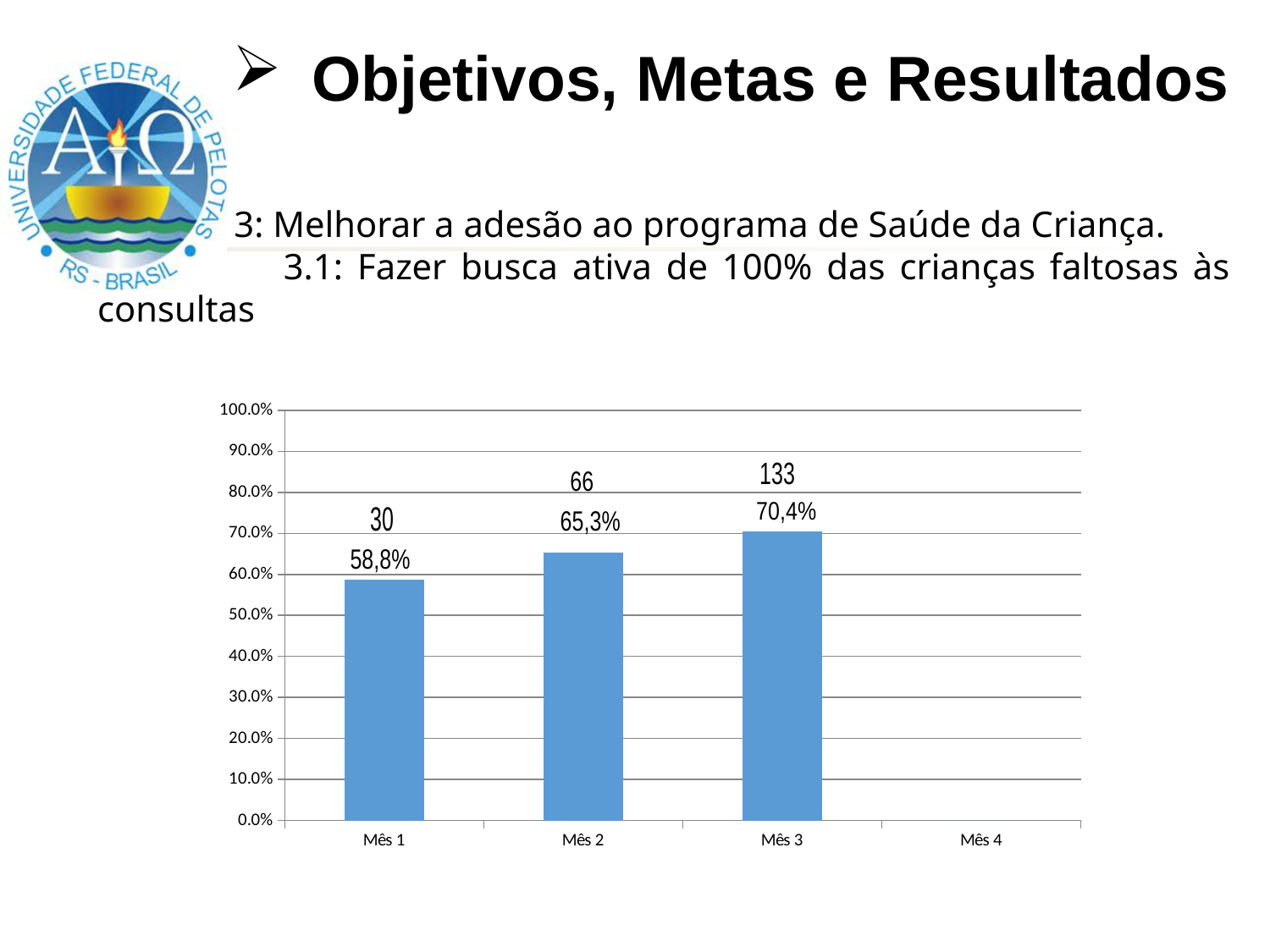
Is the value for Mês 2 greater or less than 60.0%? greater What is the percentage value shown for Mês 3? 70,4% What is the percentage value shown for Mês 1? 58,8% Which is larger, the percentage for Mês 2 or for Mês 1? Mês 2 Which month with a plotted bar has the lowest percentage value? Mês 1 What is the difference between the numbers printed above the bars for Mês 3 and Mês 2? 67 What is the difference in percentage points between Mês 3 and Mês 1? 11,6% How many bars are plotted on the chart? 3 What number is printed above the bar for Mês 3? 133 What number is printed above the bar for Mês 2? 66 Do the percentage values rise or fall from Mês 1 to Mês 3? rise Which month has the highest percentage value? Mês 3